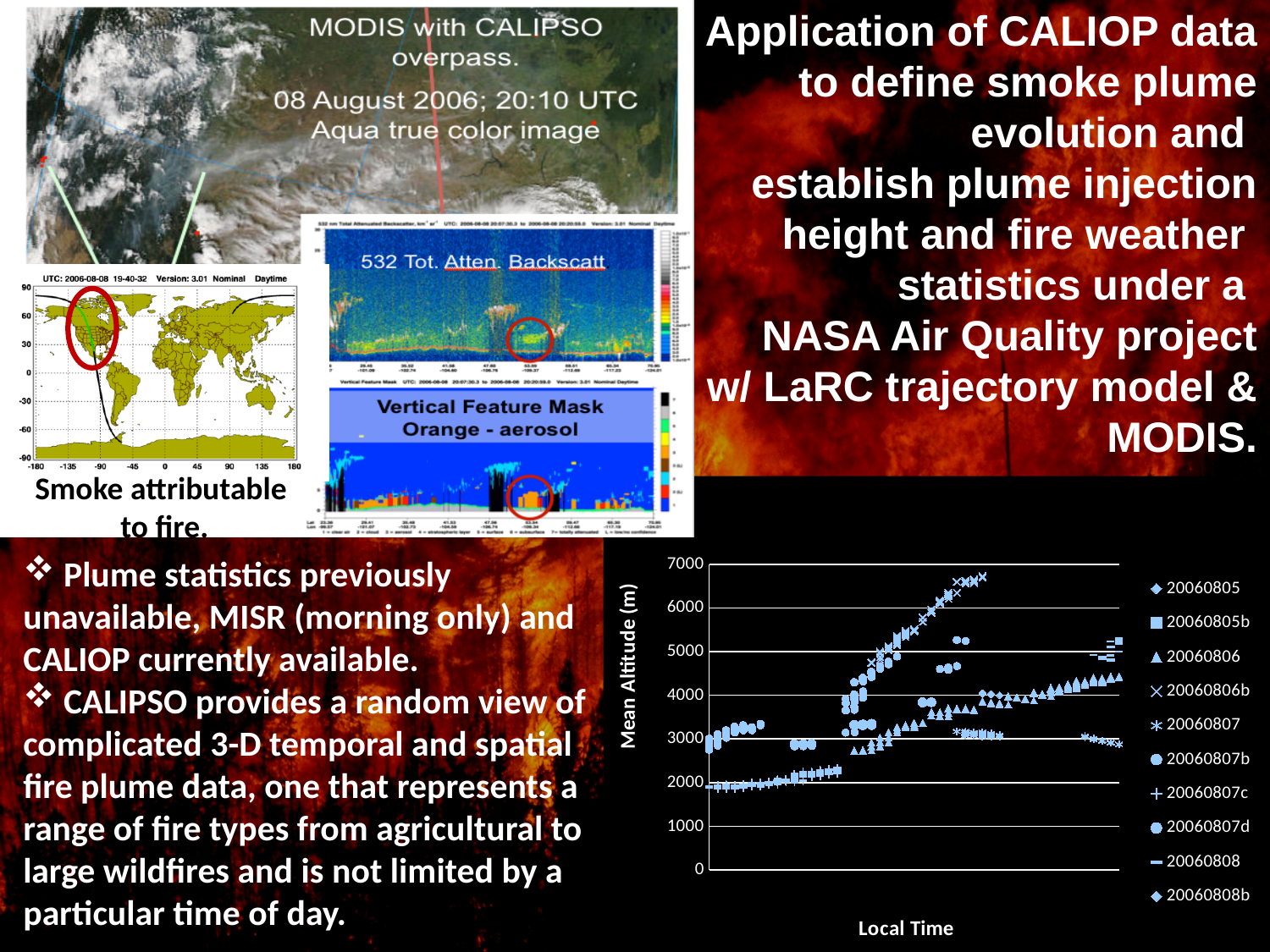
In the bottom-right chart, do the values of the 20060806 series rise or fall along the x axis? rise What is the label of the horizontal axis of the bottom-right chart? Local Time What kind of chart is shown at the bottom right of the slide? scatter chart In the bottom-right chart, are the values of the 20060807c series greater or less than 3000? less In the bottom-right chart, are the values of the 20060805 series greater or less than 4000? less In the bottom-right chart, is the highest value of the 20060806 series greater or less than 4000? greater How many series does the legend of the bottom-right chart list? 10 What is the label of the vertical axis of the bottom-right chart? Mean Altitude (m) In the bottom-right chart, which series reaches the highest mean altitude, 20060806b or 20060807c? 20060806b